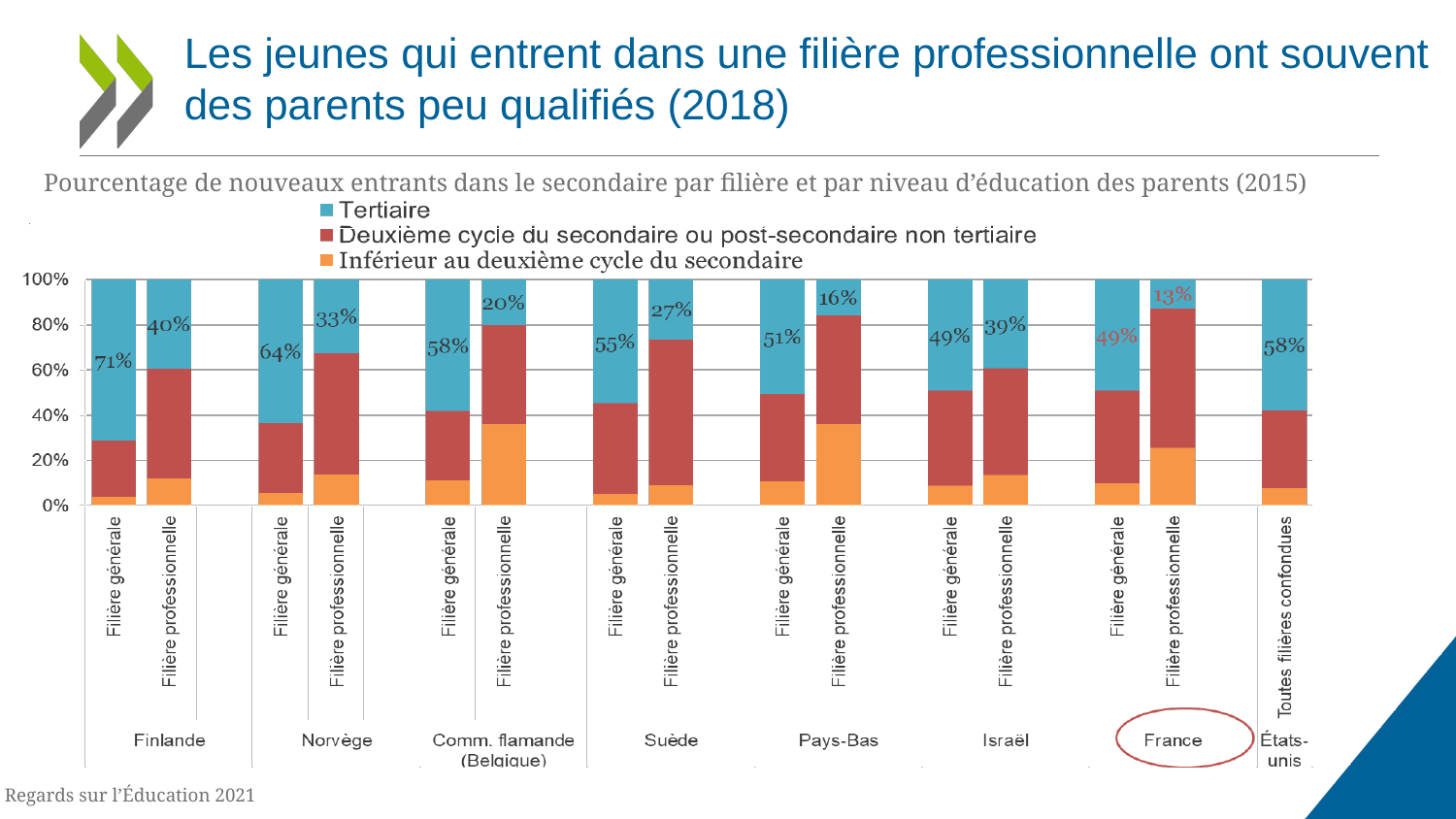
How many series does the legend list? 3 What percentage of new entrants in the Finlande filière générale have parents with tertiary education (Tertiaire)? 71% What Tertiaire value is labelled for the États-Unis 'Toutes filières confondues' bar? 58% Is the 'Inférieur au deuxième cycle du secondaire' share for the Comm. flamande (Belgique) filière professionnelle greater or less than 20%? greater What is the Tertiaire percentage for the Pays-Bas filière professionnelle? 16% What is the Tertiaire share shown for the France filière professionnelle bar? 13% Which colour represents the 'Tertiaire' series in the legend? Blue What kind of chart is shown on the slide? Stacked bar chart What is the difference in Tertiaire share between the France filière générale and the France filière professionnelle? 36 percentage points Which has a larger Tertiaire share: the Israël filière professionnelle or the Pays-Bas filière professionnelle? Israël filière professionnelle Which bar has the highest labelled Tertiaire share? Finlande, Filière générale (71%) Which bar has the lowest labelled Tertiaire share? France, Filière professionnelle (13%)